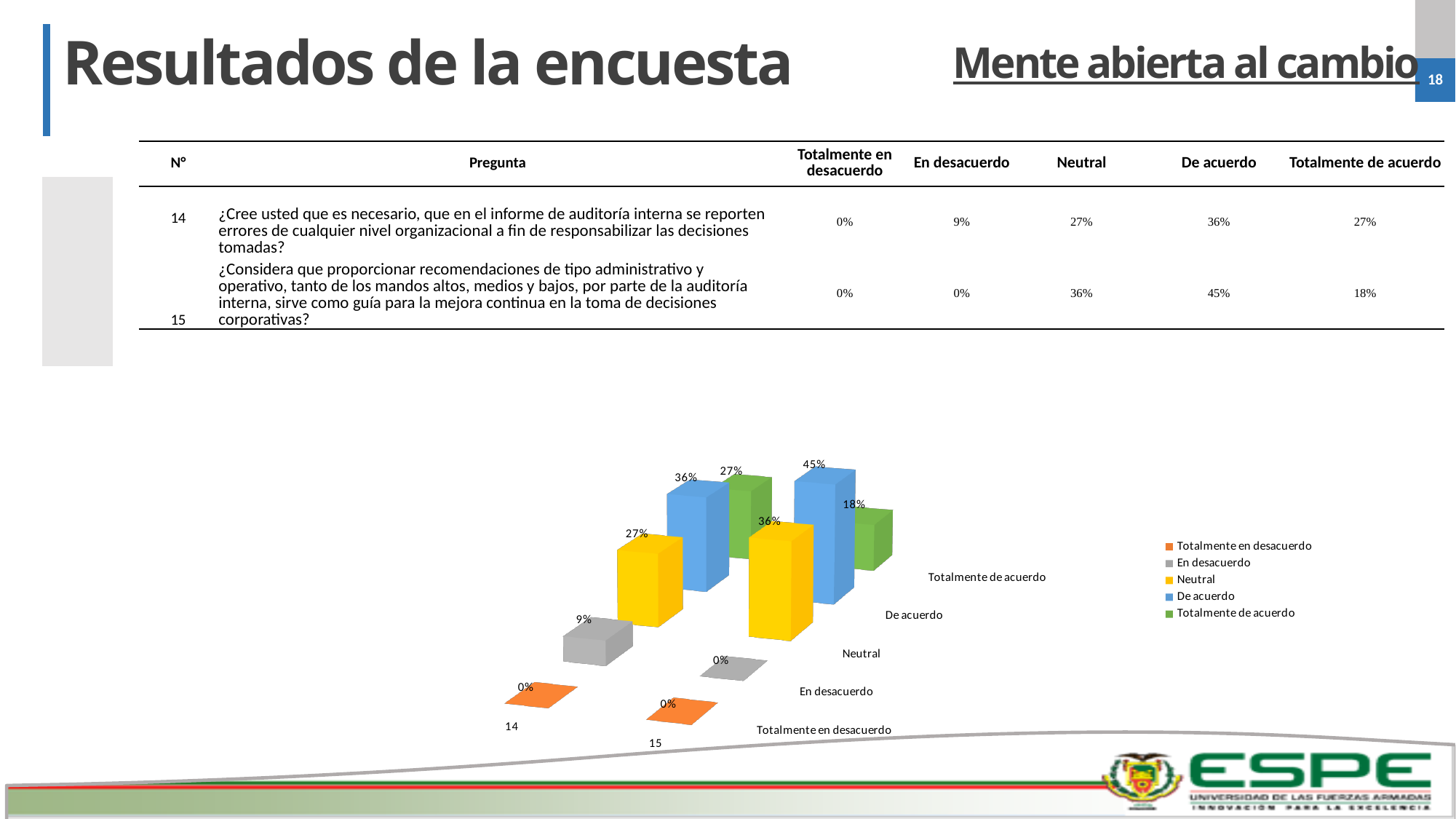
What is the value for "En desacuerdo" for question 14? 9% Which series has the highest value for question 14? De acuerdo What is the value for "Neutral" for question 15? 36% What colour represents the "Neutral" series in the chart? Yellow How many series does the legend list? 5 What is the difference between the "De acuerdo" values for question 15 and question 14? 9% Which is larger: "Totalmente de acuerdo" for question 14 or for question 15? Question 14 What kind of chart is shown on the slide? Bar chart Which series has the highest value for question 15? De acuerdo What is the value for "Totalmente de acuerdo" for question 15? 18% What is the value for "De acuerdo" for question 14? 36% How many question categories are plotted on the chart? 2